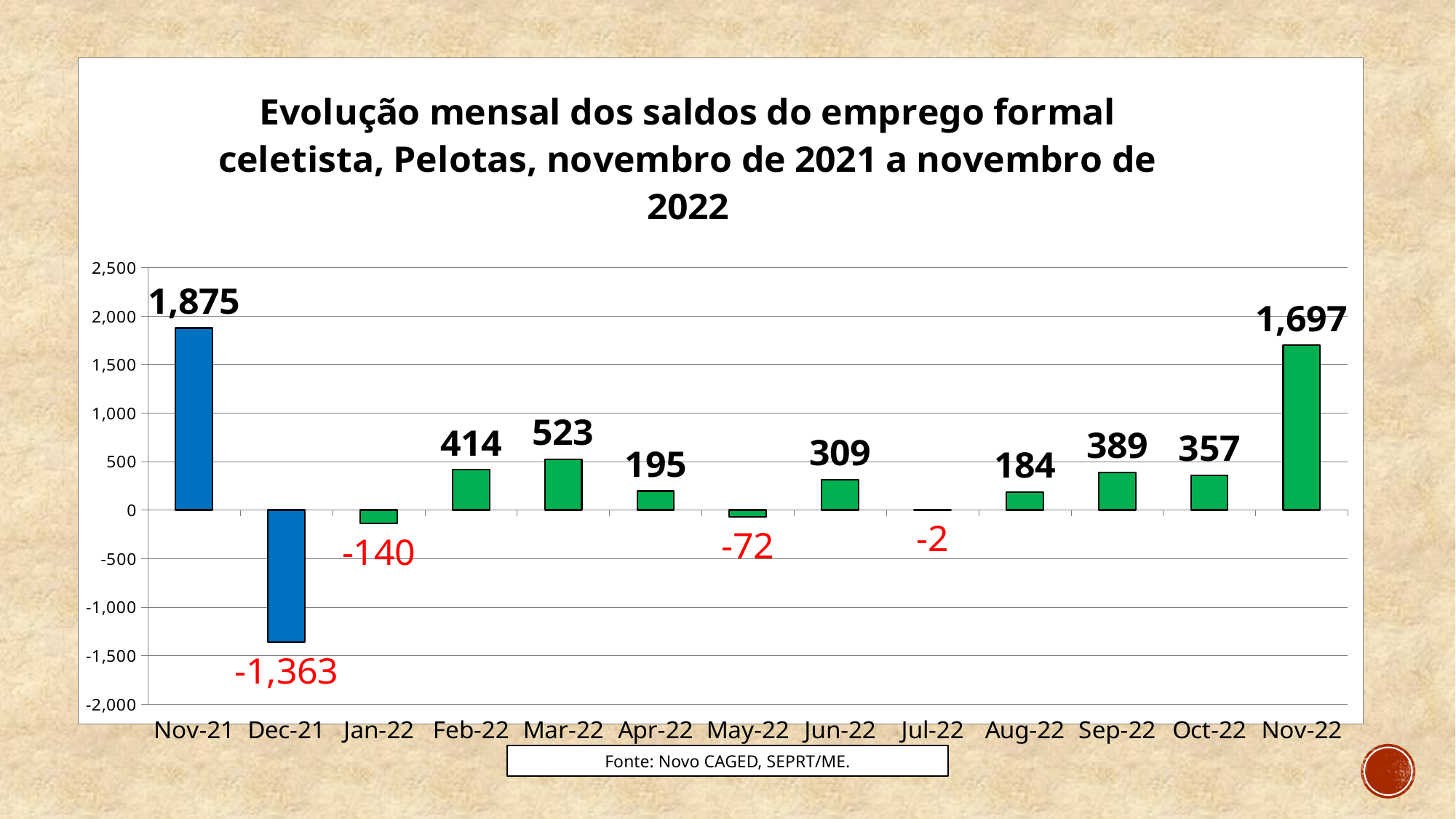
How many months have a negative value? 4 What is the value for Jul-22? -2 How many months are shown on the x axis? 13 What is the difference between the values for Nov-21 and Nov-22? 178 What kind of chart is shown on the slide? bar chart Which month has the highest value? Nov-21 What is the value for Nov-21? 1,875 What is the source cited below the chart? Novo CAGED, SEPRT/ME. What is the value for Mar-22? 523 Which is larger, the value for Sep-22 or the value for Oct-22? Sep-22 What is the value for Dec-21? -1,363 Which month has the lowest value? Dec-21